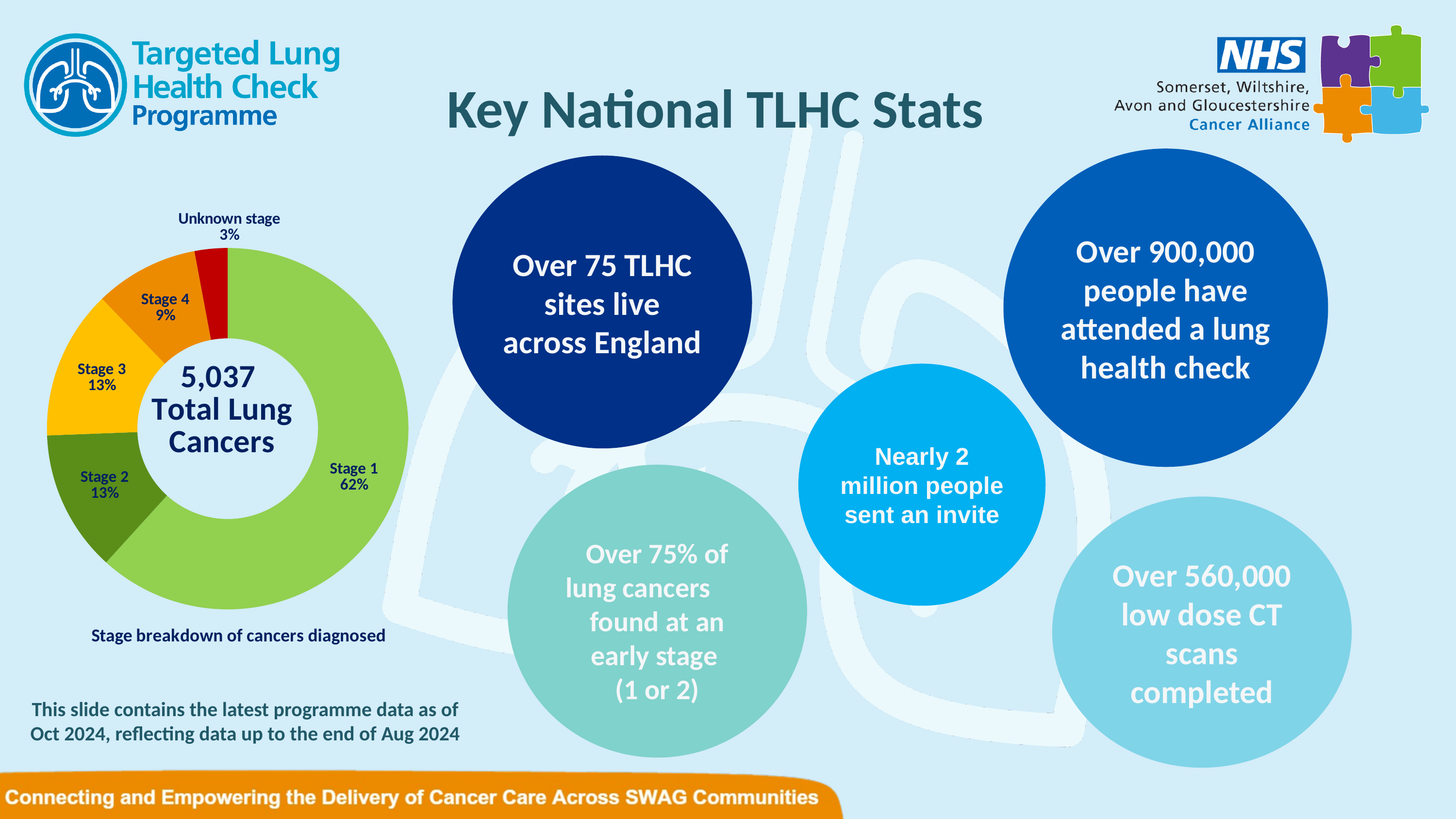
Which is larger in the donut chart, Stage 4 or Unknown stage? Stage 4 What kind of chart is used to show the stage breakdown of cancers diagnosed? Donut (pie) chart What total number of lung cancers is shown in the centre of the donut chart? 5,037 What percentage is shown for Unknown stage in the donut chart? 3% What is the difference in percentage points between Stage 1 and Stage 4 in the donut chart? 53 Which stage has the largest share in the donut chart? Stage 1 How many categories are shown in the donut chart? 5 Which category has the smallest share in the donut chart? Unknown stage What percentage of cancers diagnosed are Stage 4 in the donut chart? 9% What is the caption below the donut chart? Stage breakdown of cancers diagnosed What is the combined percentage of Stage 2 and Stage 3 in the donut chart? 26% What share of the donut chart is Stage 1? 62%